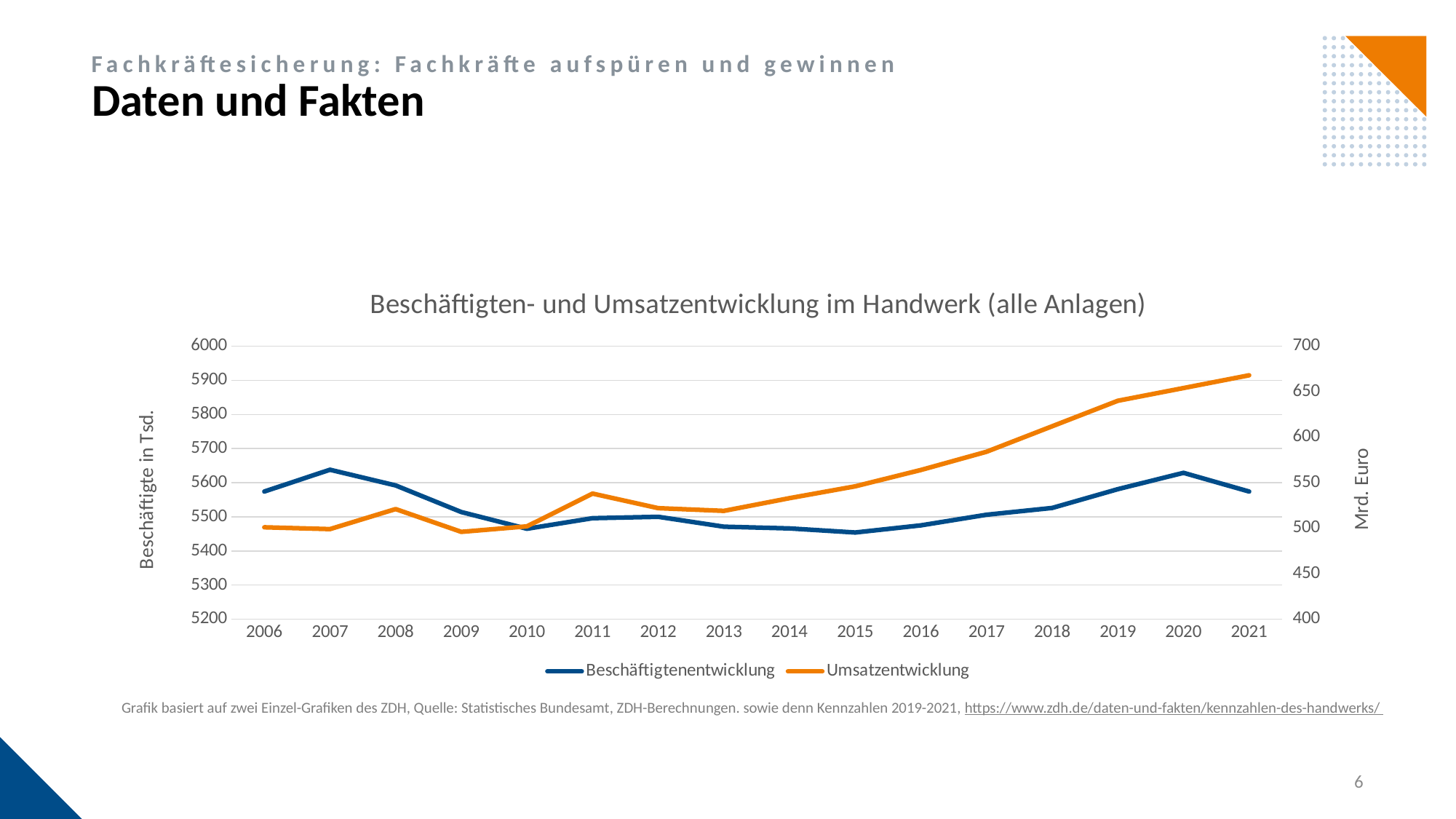
Is the Umsatzentwicklung value for 2006 greater or less than 550? less Which year has the larger Beschäftigtenentwicklung value, 2007 or 2015? 2007 Is the Beschäftigtenentwicklung value for 2015 greater or less than 5500? less What is the label of the right-hand vertical axis? Mrd. Euro Does the Umsatzentwicklung line generally rise or fall from 2006 to 2021? rise How many years are plotted along the x axis? 16 Is the Beschäftigtenentwicklung value for 2007 greater or less than 5600? greater How many series does the legend list? 2 In which year is the Umsatzentwicklung value highest? 2021 What is the title of the chart? Beschäftigten- und Umsatzentwicklung im Handwerk (alle Anlagen) What kind of chart is shown on the slide? line chart